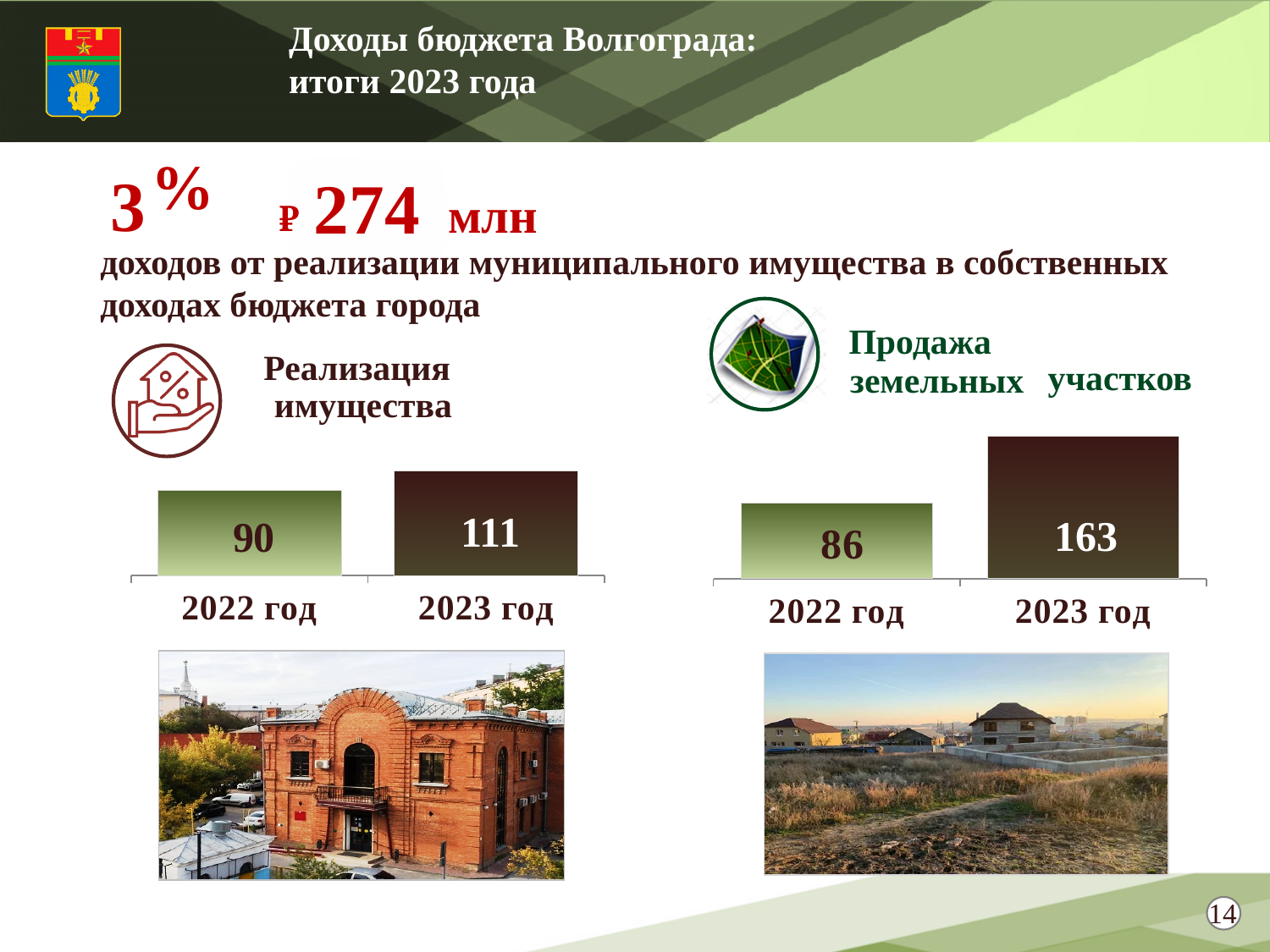
In the 'Продажа земельных участков' chart, which year has the lower value? 2022 год In the 'Продажа земельных участков' chart, do the values rise or fall from 2022 год to 2023 год? Rise In the 'Продажа земельных участков' chart, what is the difference between the 2023 год and 2022 год values? 77 How many categories does the 'Продажа земельных участков' chart show? 2 In the 'Реализация имущества' chart, what is the value for 2023 год? 111 In the 'Продажа земельных участков' chart, what is the value for 2023 год? 163 What kind of chart is the 'Реализация имущества' chart? Bar chart In the 'Реализация имущества' chart, which year has the higher value? 2023 год In the 'Продажа земельных участков' chart, what is the value for 2022 год? 86 In the 'Реализация имущества' chart, what is the value for 2022 год? 90 Which is larger: the 2023 год value in the 'Реализация имущества' chart or the 2023 год value in the 'Продажа земельных участков' chart? Продажа земельных участков (163) In the 'Реализация имущества' chart, what is the difference between the 2023 год and 2022 год values? 21